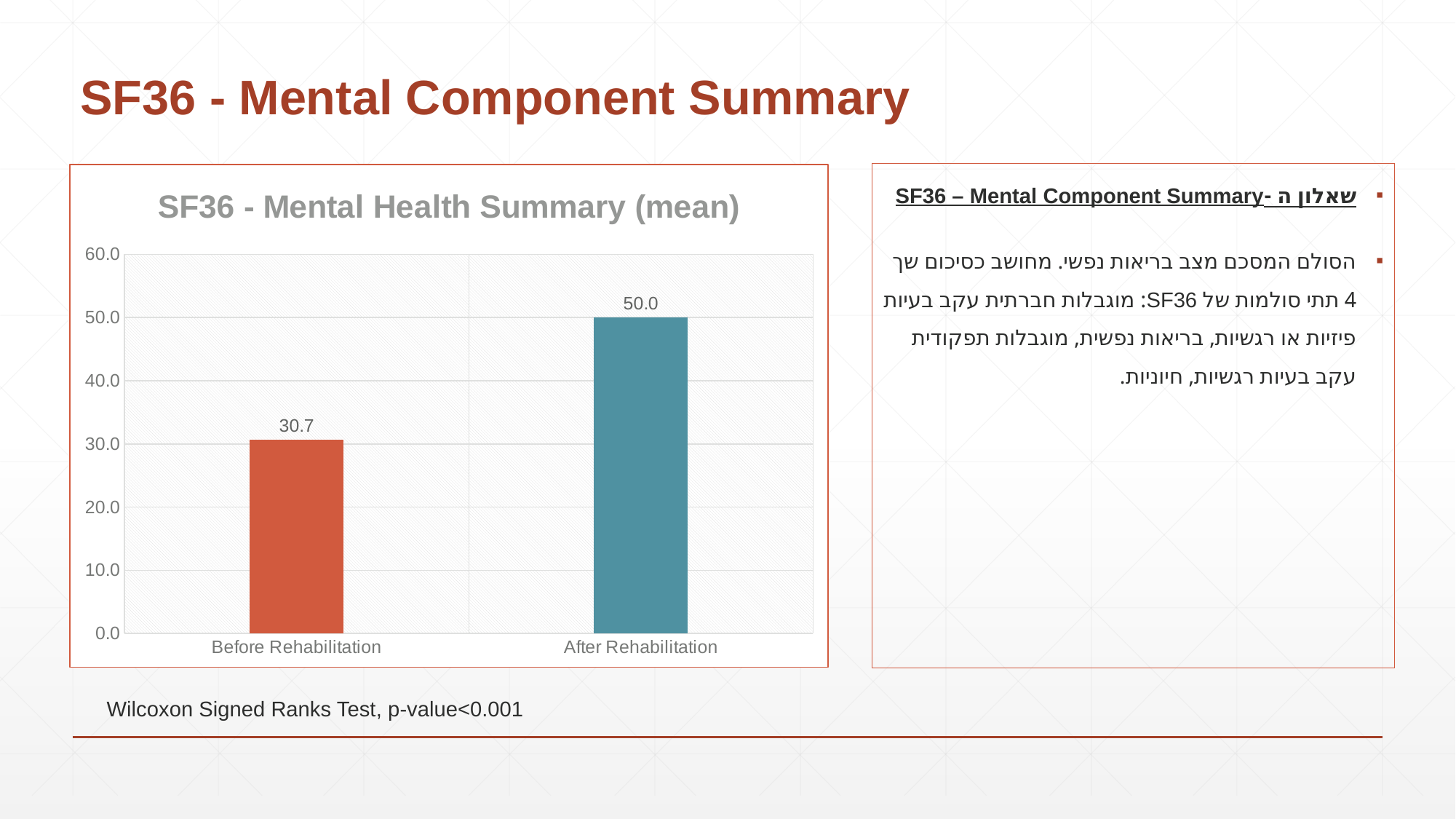
Which category has the lowest value? Before Rehabilitation What kind of chart is shown on the slide? bar chart What is the difference between the After Rehabilitation and Before Rehabilitation values? 19.3 Which category has the highest value? After Rehabilitation Is the value for Before Rehabilitation greater or less than 40.0? less Which is larger, the value for Before Rehabilitation or After Rehabilitation? After Rehabilitation Do the values rise or fall from Before Rehabilitation to After Rehabilitation? rise What colour is the After Rehabilitation bar? teal blue What is the title of the chart? SF36 - Mental Health Summary (mean) What is the value for Before Rehabilitation? 30.7 How many categories are shown on the x axis? 2 What is the value for After Rehabilitation? 50.0